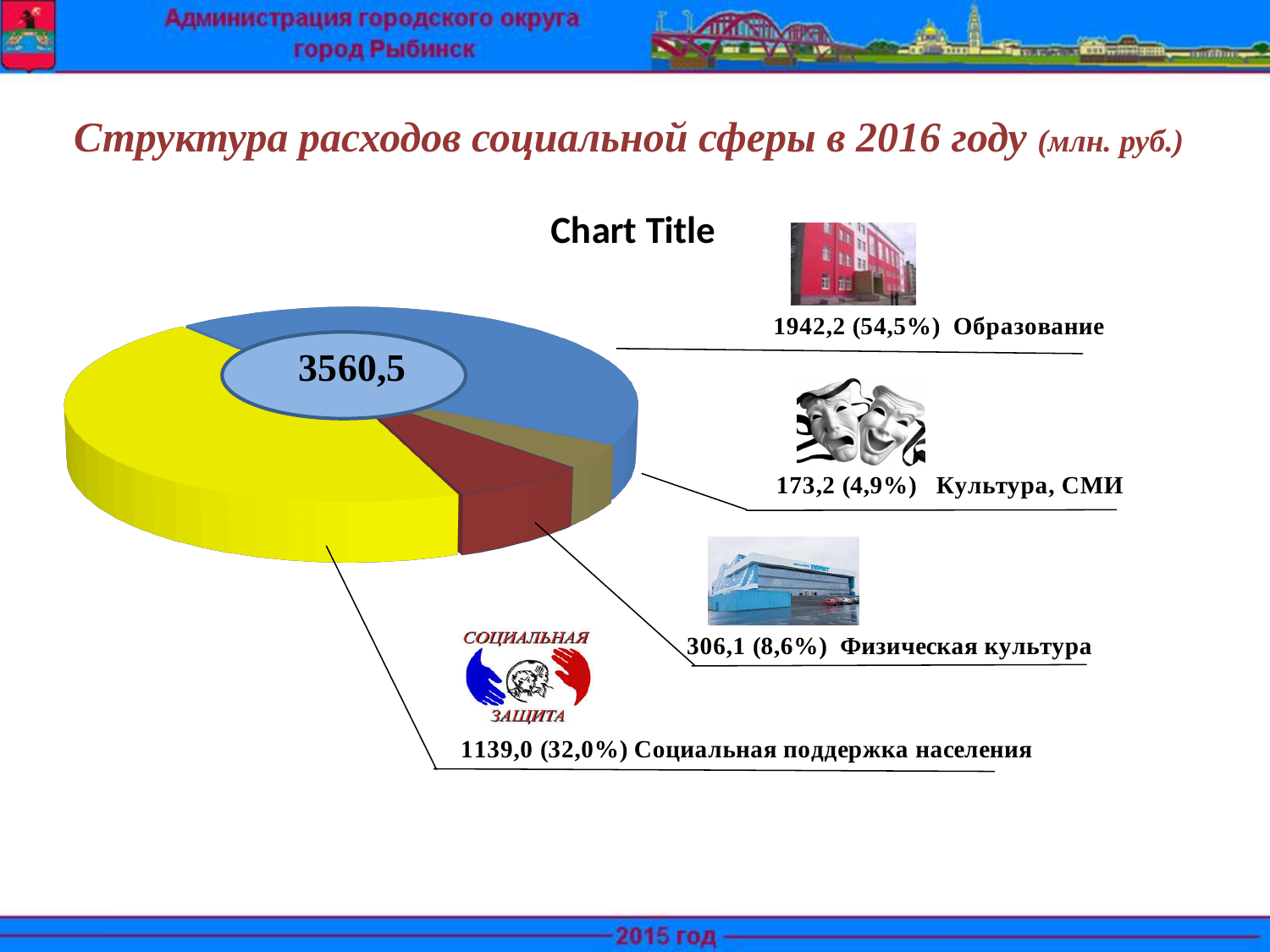
What kind of chart is shown on the slide? pie chart What is the value for Физическая культура? 306,1 What is the value for Социальная поддержка населения? 1139,0 What share of the pie does Социальная поддержка населения represent? 32,0% Which category has the largest value? Образование Which category has the smallest value? Культура, СМИ What is the value for Культура, СМИ? 173,2 What is the difference between the values for Физическая культура and Культура, СМИ? 132,9 What total value is shown in the centre of the pie chart? 3560,5 What is the value for Образование? 1942,2 How many slices does the pie chart have? 4 What share of the pie does Образование represent? 54,5%